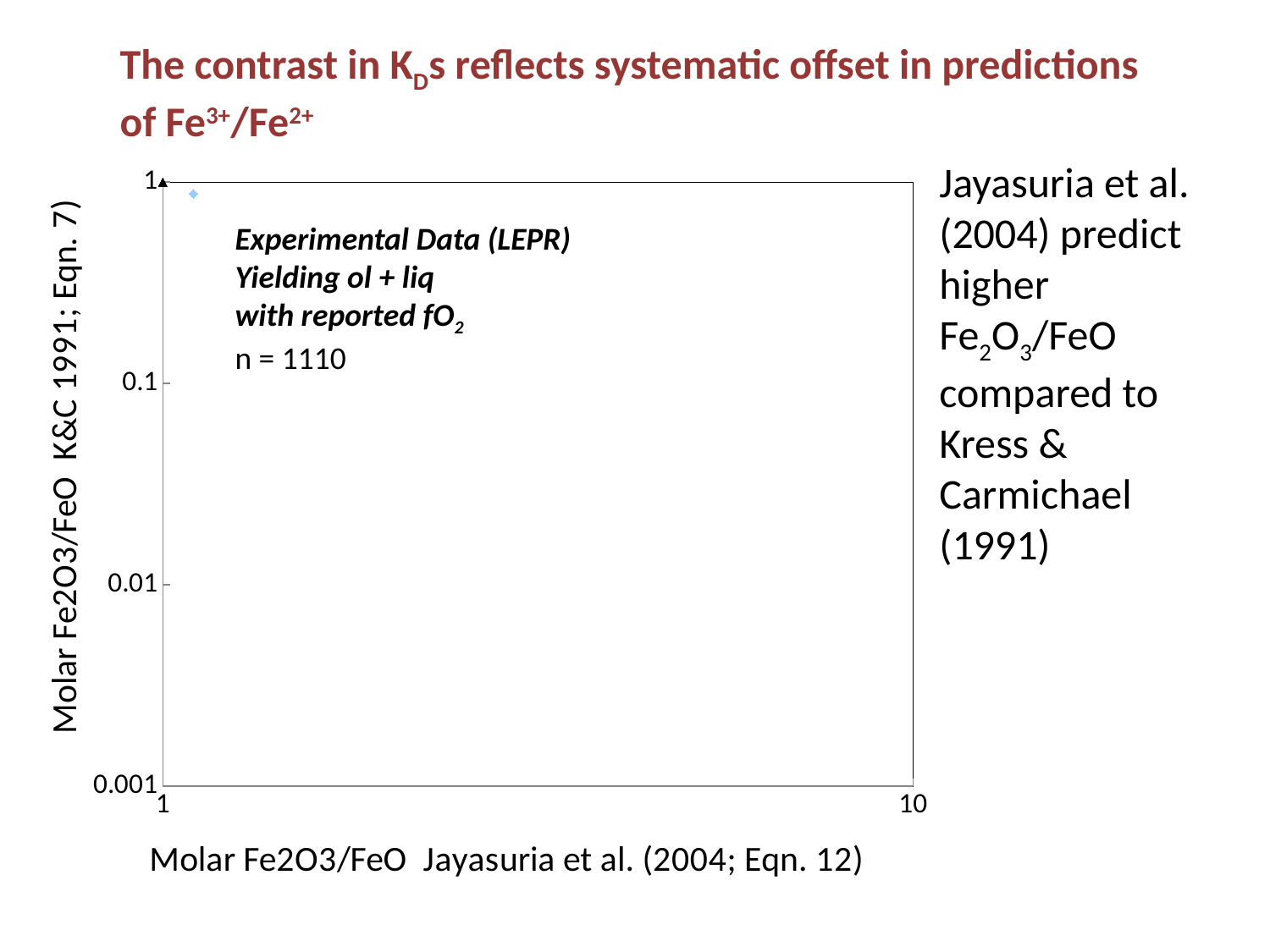
What is the label of the y axis of the chart? Molar Fe2O3/FeO K&C 1991; Eqn. 7 Is the y value of the plotted point greater or less than 0.1? greater What is the lowest tick value shown on the x axis of the chart? 1 How many tick values are labelled on the y axis of the chart? 4 What kind of chart is shown on the slide? scatter chart How many data points are visibly plotted on the chart? 1 What is the lowest tick value shown on the y axis of the chart? 0.001 According to the annotation on the chart, what is the value of n? n = 1110 Is the x value of the plotted point greater or less than 10? less What is the highest tick value shown on the x axis of the chart? 10 What is the label of the x axis of the chart? Molar Fe2O3/FeO Jayasuria et al. (2004; Eqn. 12) What is the highest tick value shown on the y axis of the chart? 1